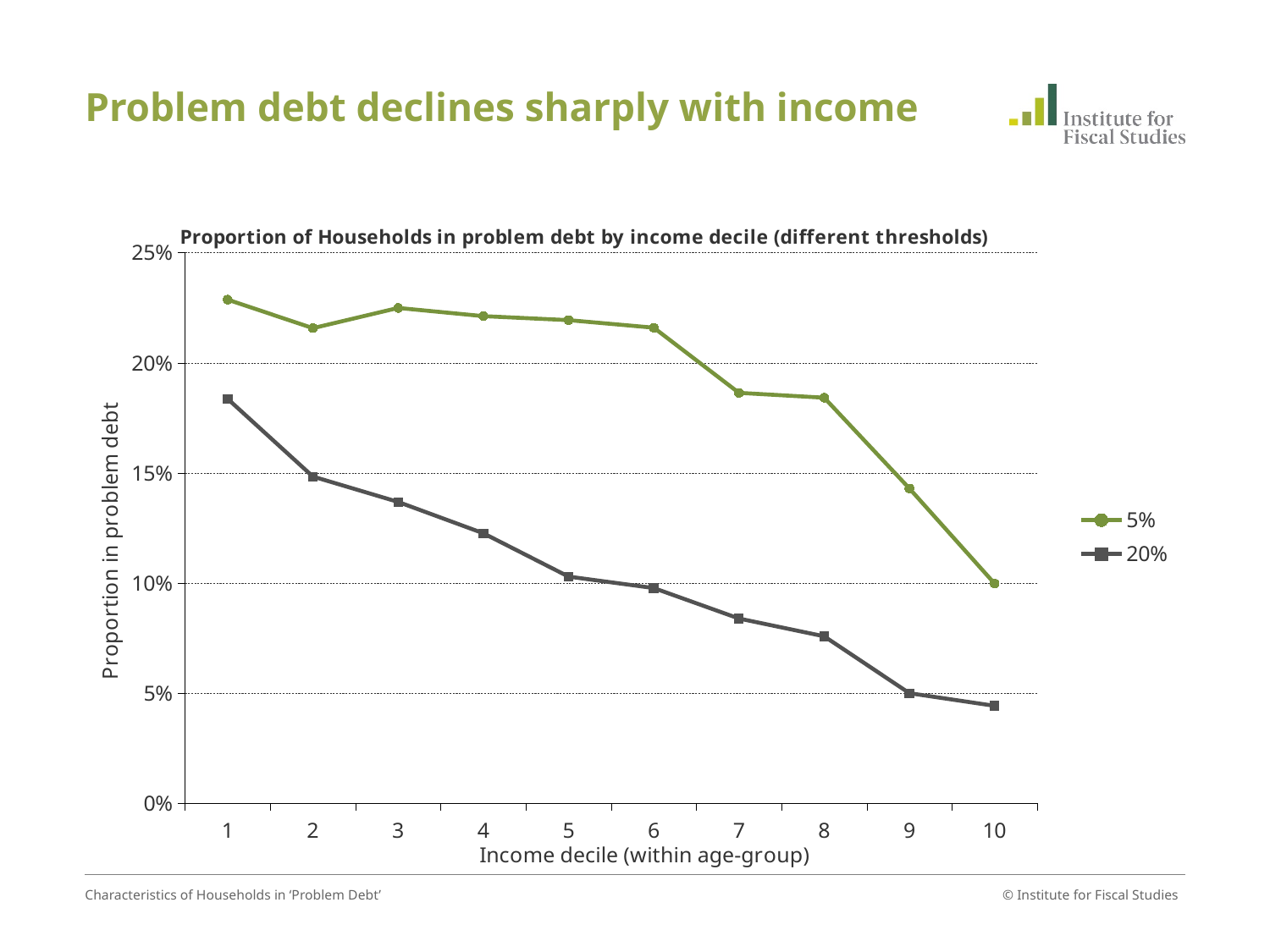
Is the value for the 20% series at income decile 10 greater or less than 5%? less What kind of chart is shown on the slide? line chart How many series does the legend list? 2 Do the values for the 20% series rise or fall as income decile increases? fall At income decile 1, which series has the higher proportion in problem debt, 5% or 20%? 5% Is the value for the 20% series at income decile 7 greater or less than 10%? less What is the title of the chart? Proportion of Households in problem debt by income decile (different thresholds) Is the value for the 5% series at income decile 9 greater or less than 15%? less For the 20% series, which income decile has the highest proportion in problem debt? 1 For the 5% series, which income decile has the lowest proportion in problem debt? 10 How many income deciles are plotted along the x axis? 10